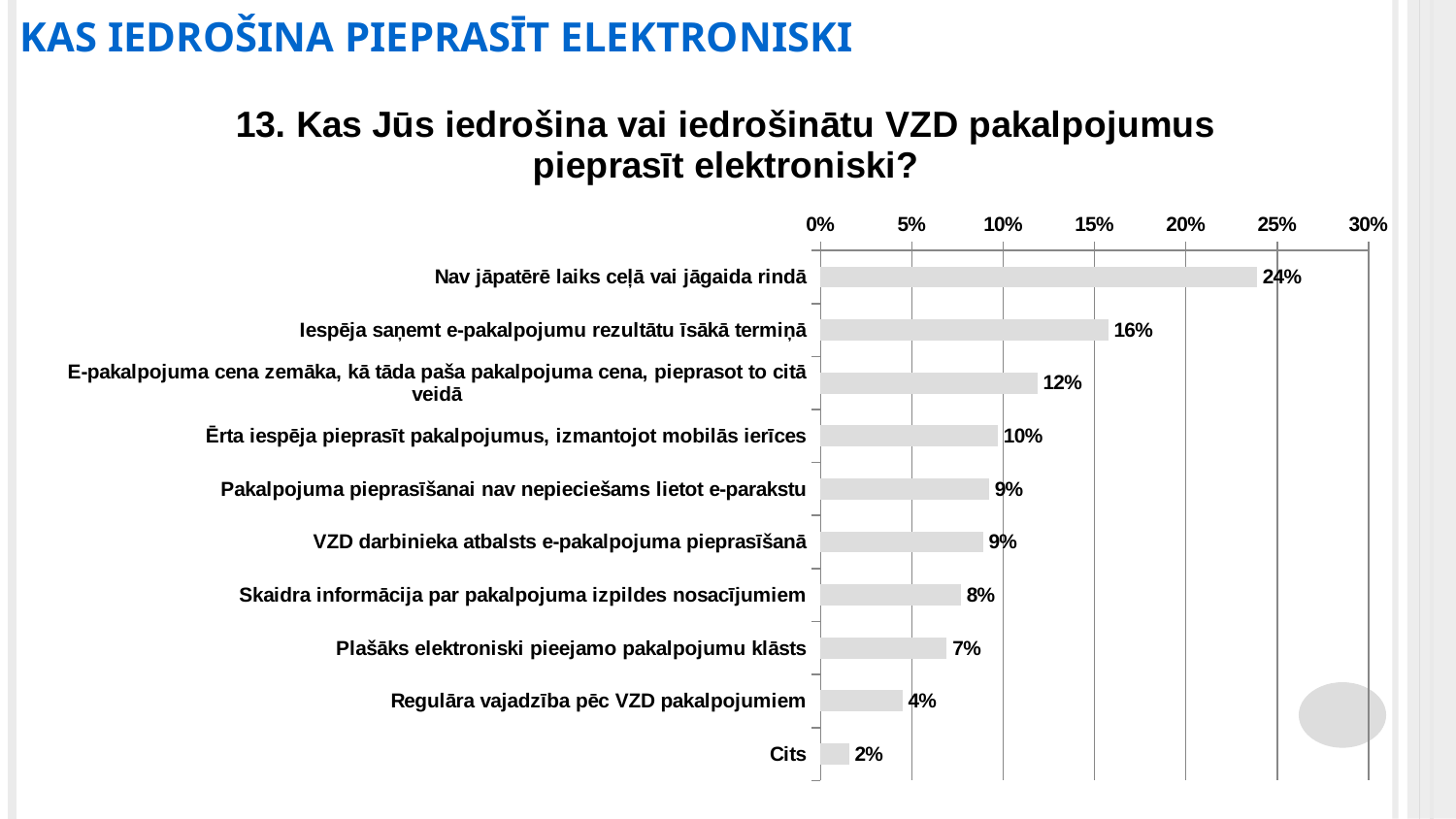
Which is larger: the value for "Ērta iespēja pieprasīt pakalpojumus, izmantojot mobilās ierīces" or "Plašāks elektroniski pieejamo pakalpojumu klāsts"? Ērta iespēja pieprasīt pakalpojumus, izmantojot mobilās ierīces What is the difference between the values for "Nav jāpatērē laiks ceļā vai jāgaida rindā" and "Iespēja saņemt e-pakalpojumu rezultātu īsākā termiņā"? 8% Which category has the lowest value? Cits Is the value for "Skaidra informācija par pakalpojuma izpildes nosacījumiem" greater or less than 10%? less What kind of chart is shown on the slide? Bar chart What is the value for "Nav jāpatērē laiks ceļā vai jāgaida rindā"? 24% How many categories are shown in the chart? 10 Which category has the highest value? Nav jāpatērē laiks ceļā vai jāgaida rindā What is the value for "Cits"? 2% What is the highest value shown on the percentage axis? 30% What is the value for "Iespēja saņemt e-pakalpojumu rezultātu īsākā termiņā"? 16% What is the value for "Regulāra vajadzība pēc VZD pakalpojumiem"? 4%